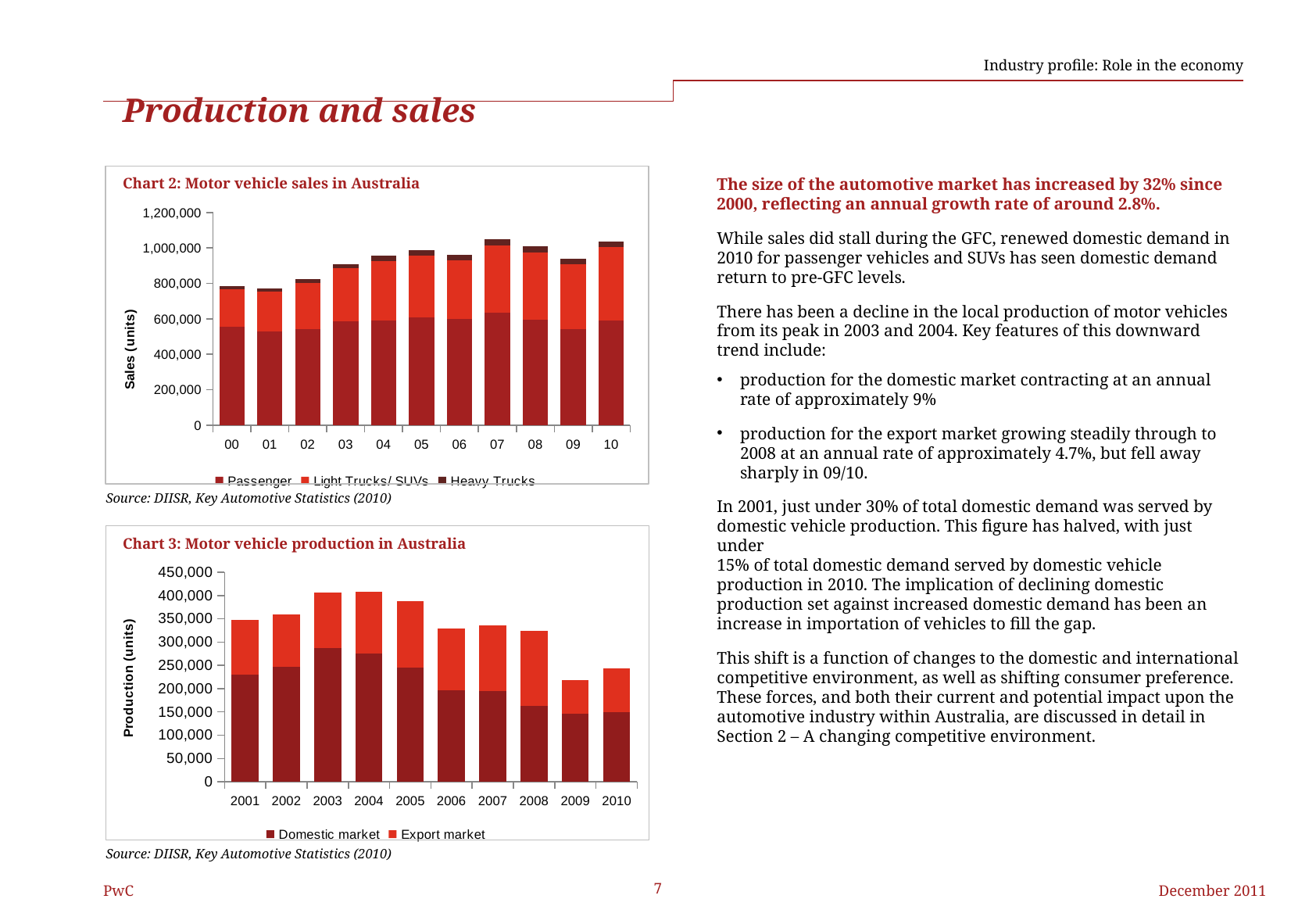
In Chart 3: Motor vehicle production in Australia, which year has the lowest total production? 2009 In Chart 2: Motor vehicle sales in Australia, is the total sales value for 07 greater or less than 1,000,000? greater In Chart 3: Motor vehicle production in Australia, do total production values rise or fall from 2004 to 2009? fall In Chart 2: Motor vehicle sales in Australia, is the Passenger value for 07 greater or less than 600,000? greater What is the y-axis label of Chart 2: Motor vehicle sales in Australia? Sales (units) How many years are shown on the x axis of Chart 3: Motor vehicle production in Australia? 10 What kind of chart is Chart 2: Motor vehicle sales in Australia? Stacked bar chart How many years are shown on the x axis of Chart 2: Motor vehicle sales in Australia? 11 How many series does the legend of Chart 2: Motor vehicle sales in Australia list? 3 In Chart 2: Motor vehicle sales in Australia, is the total sales value for 01 greater or less than 800,000? less How many series does the legend of Chart 3: Motor vehicle production in Australia list? 2